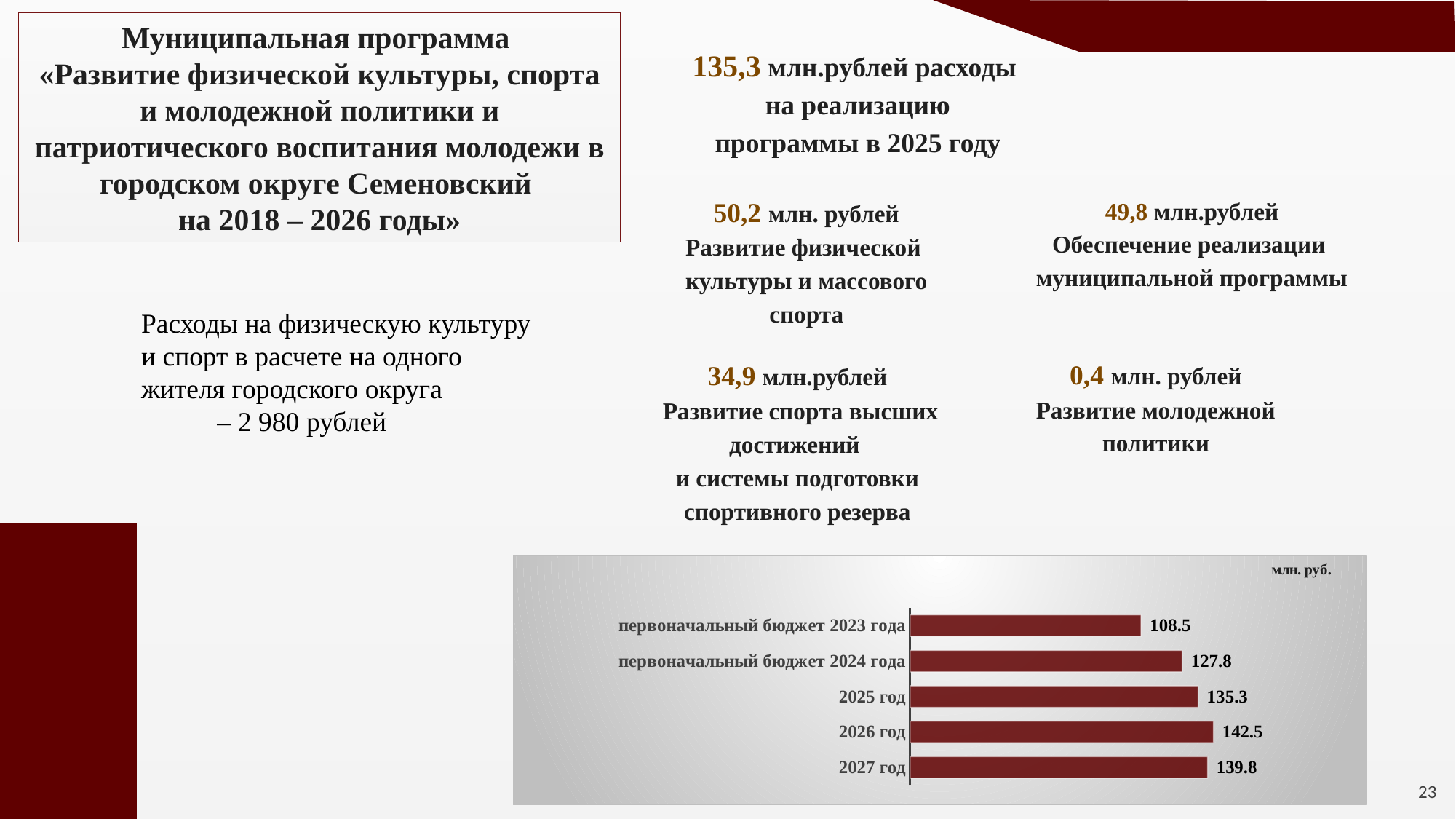
What is the value for «первоначальный бюджет 2023 года» in the bar chart? 108.5 What is the difference between the values for «2026 год» and «2027 год» in the bar chart? 2.7 What type of chart is shown at the bottom of the slide? Bar chart Which category has the lowest value in the bar chart? первоначальный бюджет 2023 года What is the value for «2027 год» in the bar chart? 139.8 How many categories (bars) does the bar chart show? 5 What is the value for «2025 год» in the bar chart? 135.3 What is the difference between the values for «первоначальный бюджет 2024 года» and «первоначальный бюджет 2023 года»? 19.3 Which is larger in the bar chart: the value for «2025 год» or for «первоначальный бюджет 2024 года»? 2025 год What unit label is shown in the top right corner of the bar chart? млн. руб. Which category has the highest value in the bar chart? 2026 год What is the value for «первоначальный бюджет 2024 года» in the bar chart? 127.8